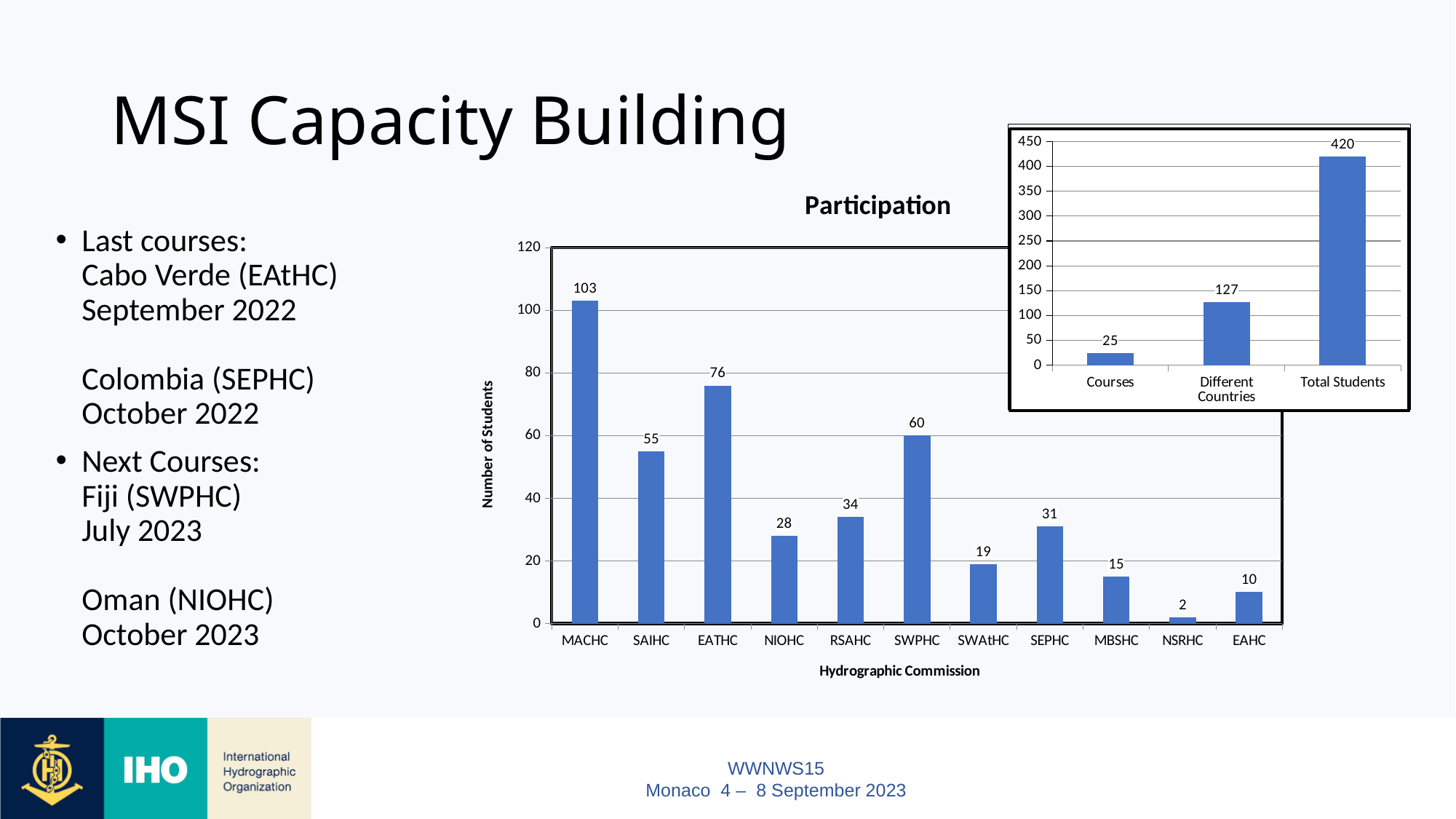
In the chart at the top right of the slide, what is the value for Total Students? 420 How many hydrographic commissions are shown on the x axis of the Participation chart? 11 What kind of chart is the Participation chart? Bar chart In the Participation chart, which hydrographic commission has the lowest number of students? NSRHC In the Participation chart, what is the number of students for SWPHC? 60 In the chart at the top right of the slide, which category has the lowest value? Courses In the Participation chart, what is the difference in number of students between EATHC and SAIHC? 21 In the Participation chart, what is the number of students for MACHC? 103 In the Participation chart, which hydrographic commission has the highest number of students? MACHC What is the y-axis label of the Participation chart? Number of Students In the Participation chart, which has more students, RSAHC or SEPHC? RSAHC In the chart at the top right of the slide, what is the value for Different Countries? 127